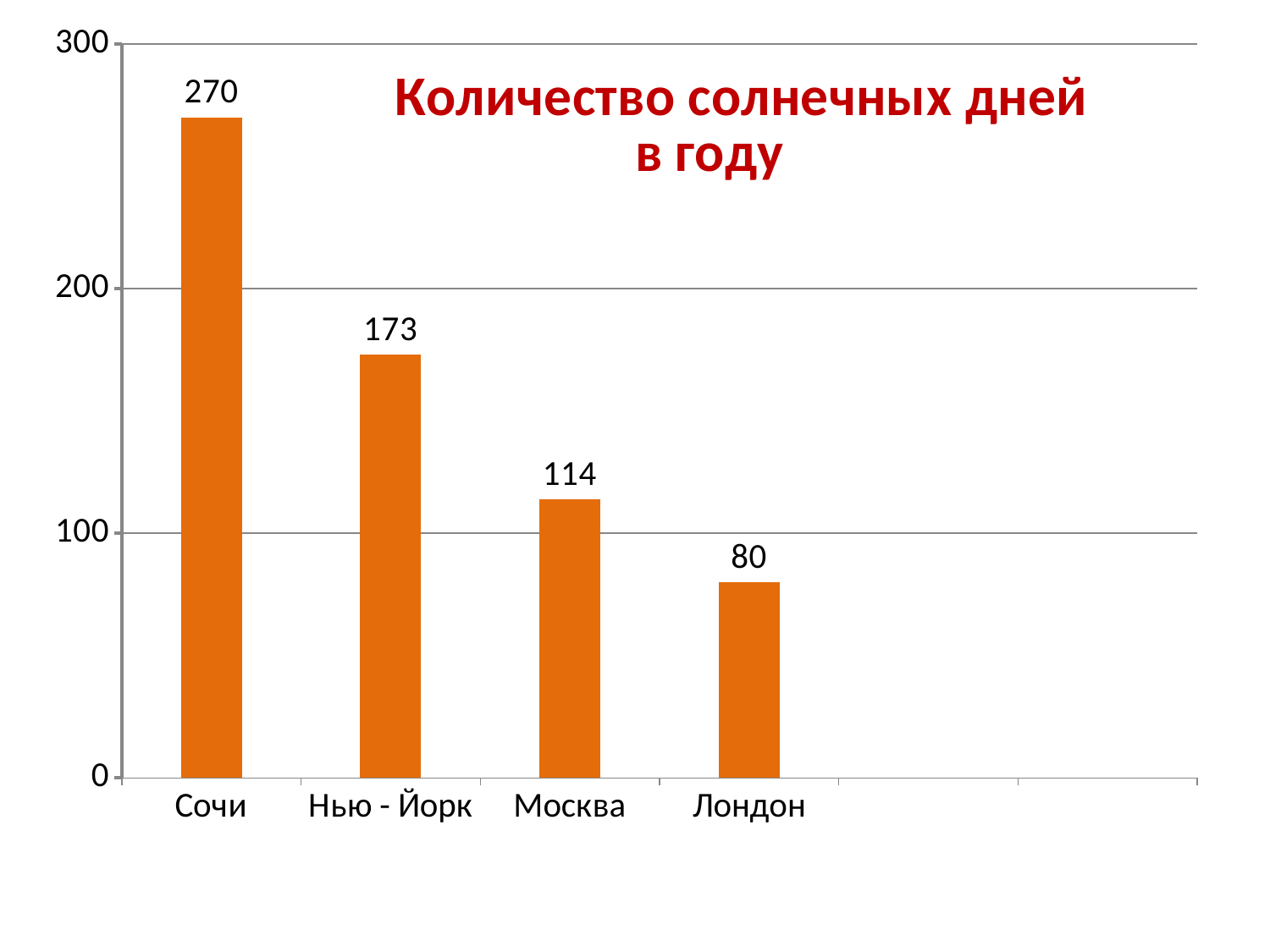
Which city has the highest number of sunny days? Сочи What kind of chart is shown on the slide? bar chart What is the difference between the values for Нью - Йорк and Москва? 59 What is the value for Москва? 114 Which city has the lowest number of sunny days? Лондон Which is larger, the value for Москва or the value for Лондон? Москва What is the value for Сочи? 270 What is the value for Нью - Йорк? 173 What is the difference between the values for Сочи and Лондон? 190 What is the title of the chart? Количество солнечных дней в году What is the value for Лондон? 80 How many cities are shown on the chart? 4